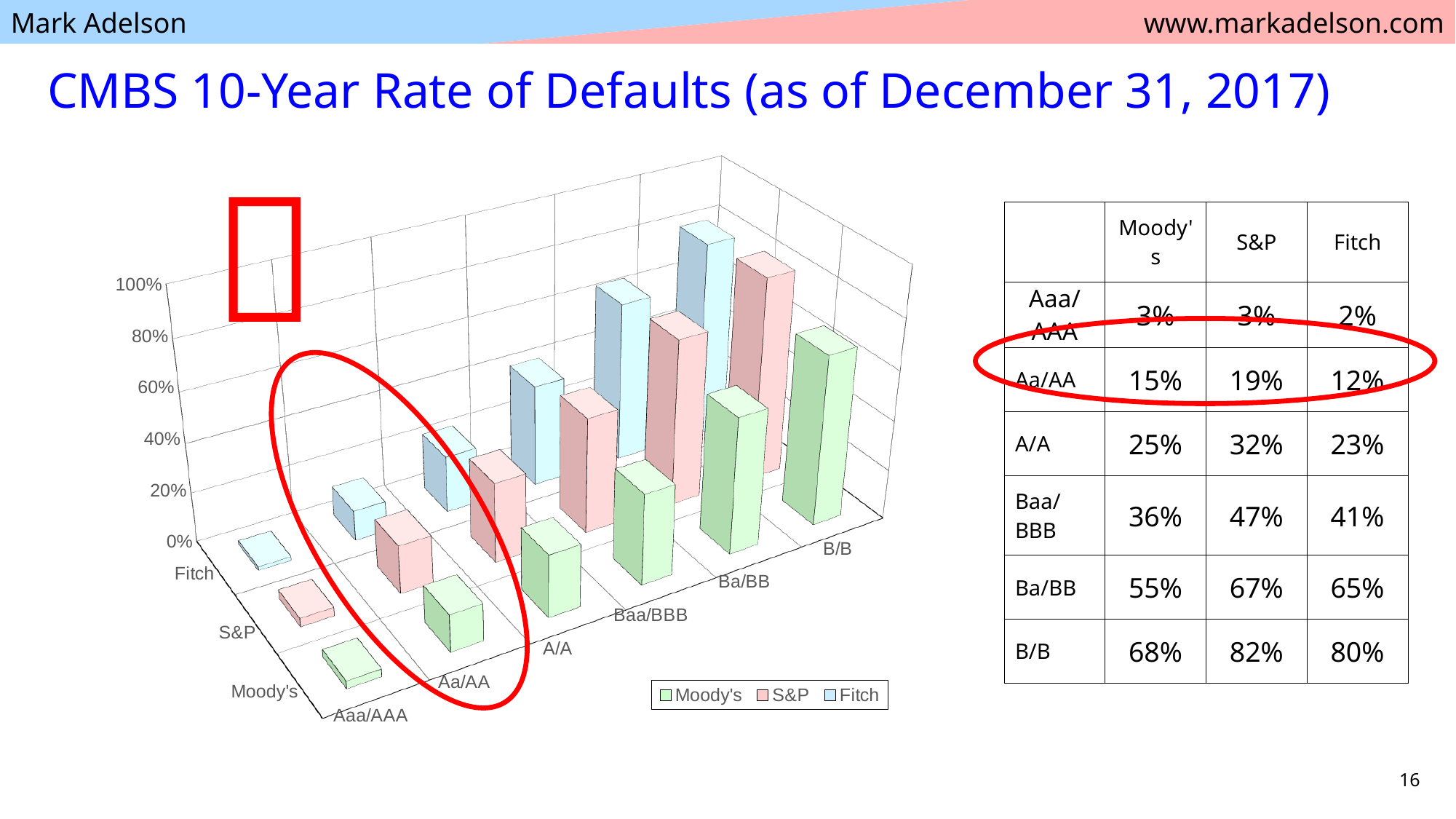
What is the 10-year default rate for Moody's in the B/B category? 68% Which colour represents Fitch in the chart legend? blue What kind of chart is shown on the slide? bar chart How many rating categories are plotted along the x axis of the chart? 6 Which rating agency has the highest default rate in the Ba/BB category? S&P Which is larger, the Fitch default rate for Ba/BB or the Moody's default rate for Ba/BB? Fitch What is the 10-year default rate for Fitch in the Baa/BBB category? 41% What is the difference between the S&P and Moody's default rates in the B/B category? 14% Do the default rates for Moody's rise or fall as the rating categories move from Aaa/AAA to B/B? rise Which rating agency has the lowest default rate in the A/A category? Fitch What is the 10-year default rate for S&P in the Aa/AA category? 19% How many series does the chart legend list? 3